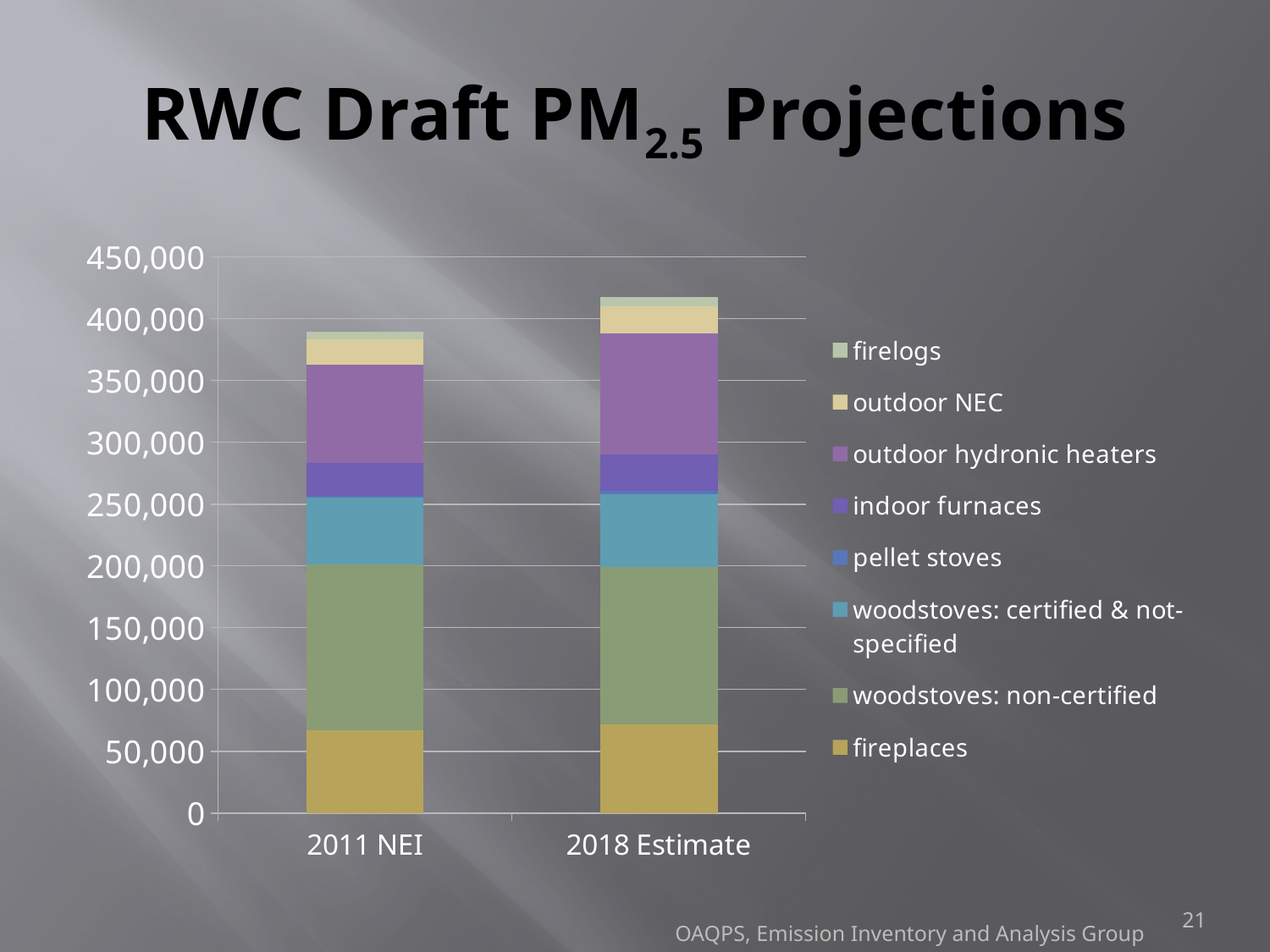
Which bar has the greater total, 2011 NEI or 2018 Estimate? 2018 Estimate Is the total for 2018 Estimate greater or less than 400,000? greater Is the total for 2011 NEI greater or less than 400,000? less Is the total for 2011 NEI greater or less than 350,000? greater Do the total bar heights rise or fall from 2011 NEI to 2018 Estimate? rise How many categories are shown on the x axis? 2 What is the title of the chart slide? RWC Draft PM2.5 Projections Which series is listed last in the legend? fireplaces How many series does the legend list? 8 What kind of chart is shown on the slide? stacked bar chart